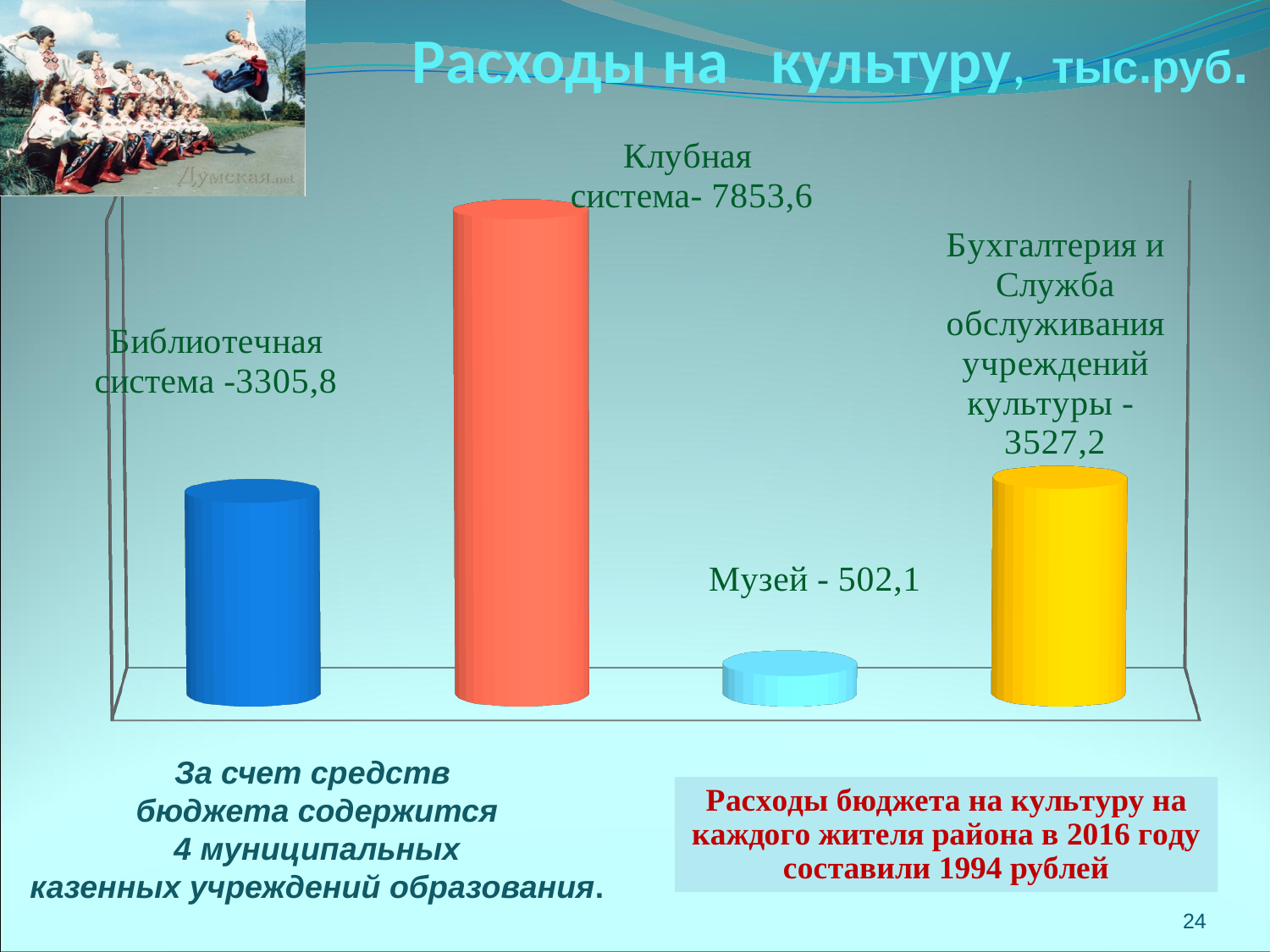
Which category has the lowest value? Музей What is the difference between the values for Клубная система and Библиотечная система? 4547,8 Which category has the highest value? Клубная система What kind of chart is shown on the slide? Bar chart What is the value for Библиотечная система? 3305,8 What is the title of the chart? Расходы на культуру, тыс.руб. What is the value for Бухгалтерия и Служба обслуживания учреждений культуры? 3527,2 What is the value for Клубная система? 7853,6 What is the value for Музей? 502,1 How many categories are shown in the chart? 4 What is the difference between the values for Бухгалтерия и Служба обслуживания учреждений культуры and Музей? 3025,1 Which is larger: the value for Бухгалтерия и Служба обслуживания учреждений культуры or the value for Библиотечная система? Бухгалтерия и Служба обслуживания учреждений культуры